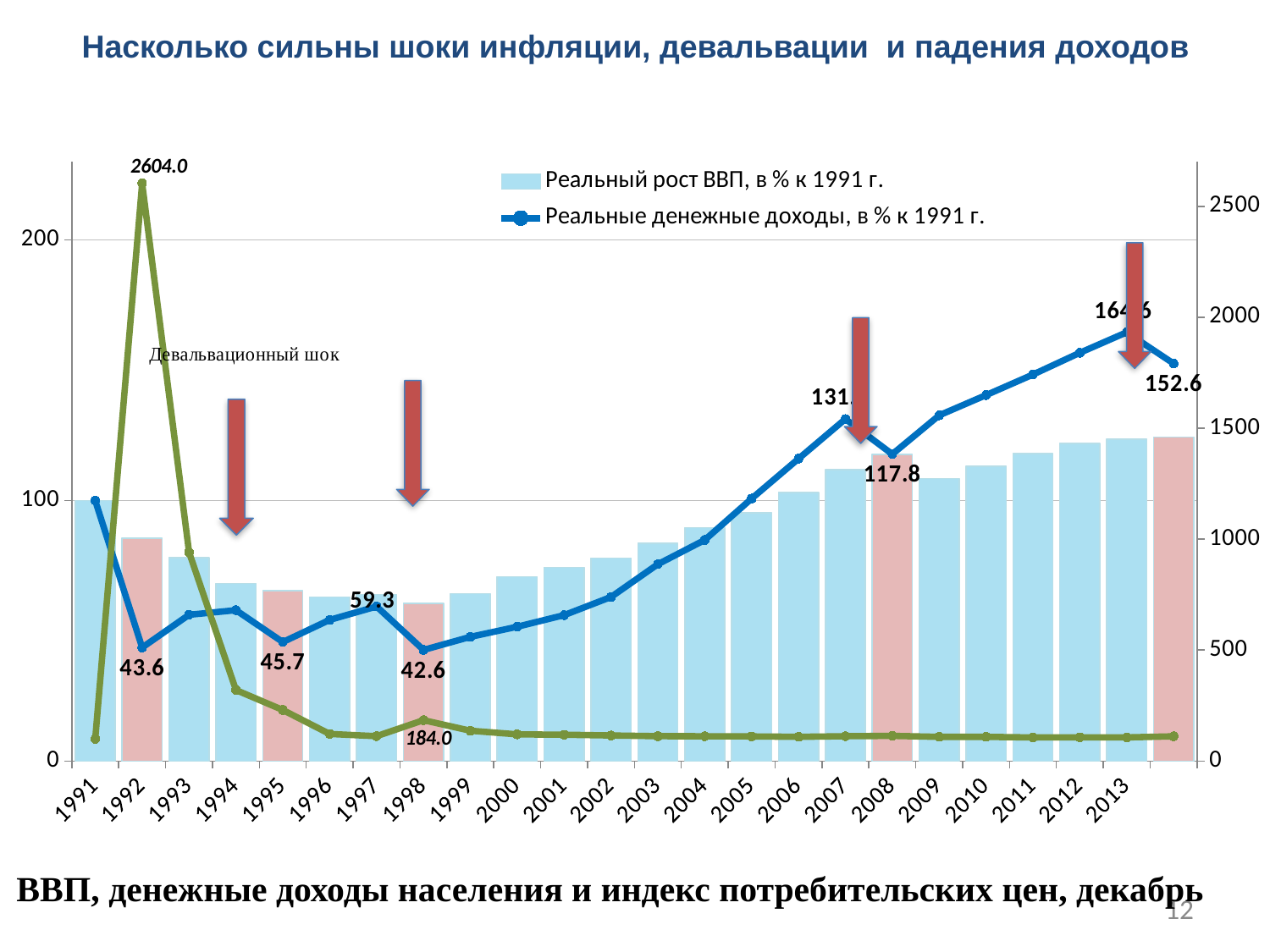
How many series does the legend list? 2 What value is labelled on the green line in 1992? 2604.0 What is the difference between real money income in 1997 (59.3) and in 1998 (42.6)? 16.7 In which year does the green line reach its highest value? 1992 What is the value of real money income in 2008? 117.8 Is the real GDP growth bar for 1992 greater or less than 100? less What is the value of real money income in 1998? 42.6 Which year has the higher real money income value, 1997 or 1998? 1997 What value is labelled on the green line in 1998? 184.0 Do the real GDP growth bars rise or fall from 1998 to 2013? rise Is the real money income value for 2006 greater or less than 100? greater What is the value of real money income (Реальные денежные доходы) in 1992? 43.6